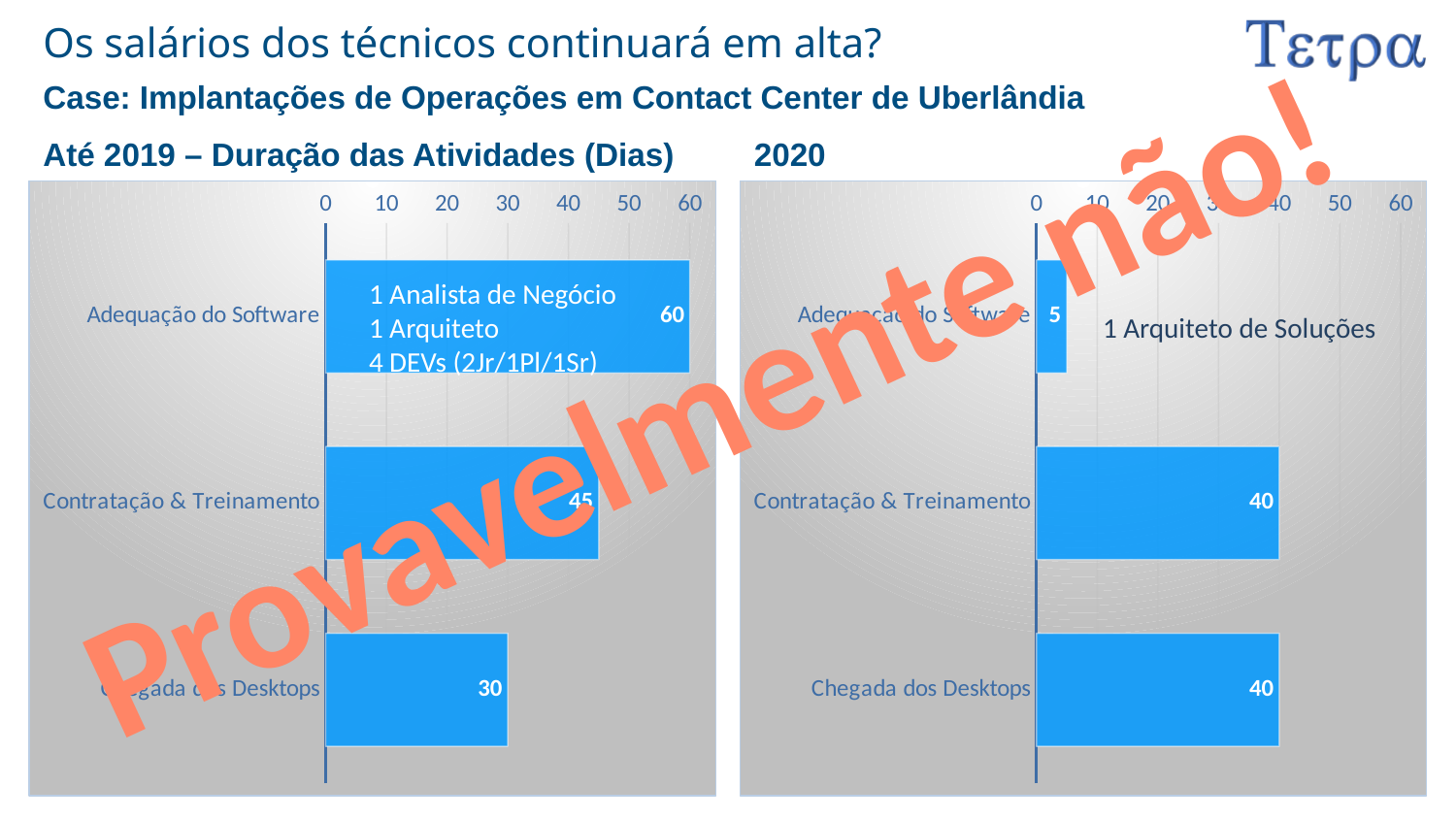
In the 'Até 2019' chart on the left, what is the difference between Adequação do Software and Chegada dos Desktops? 30 In the 'Até 2019' chart on the left, what is the value for Chegada dos Desktops? 30 In the '2020' chart on the right, what is the difference between Contratação & Treinamento and Adequação do Software? 35 What kind of chart is the 'Até 2019' chart on the left? Bar chart In the 'Até 2019' chart on the left, which category has the highest value? Adequação do Software In the '2020' chart on the right, which category has the lowest value? Adequação do Software In the '2020' chart on the right, what is the value for Contratação & Treinamento? 40 In the 'Até 2019' chart on the left, what is the value for Contratação & Treinamento? 45 How many categories are shown in the '2020' chart on the right? 3 In the 'Até 2019' chart on the left, which is larger: Contratação & Treinamento or Chegada dos Desktops? Contratação & Treinamento In the 'Até 2019' chart on the left, what is the value for Adequação do Software? 60 In the '2020' chart on the right, what is the value for Adequação do Software? 5